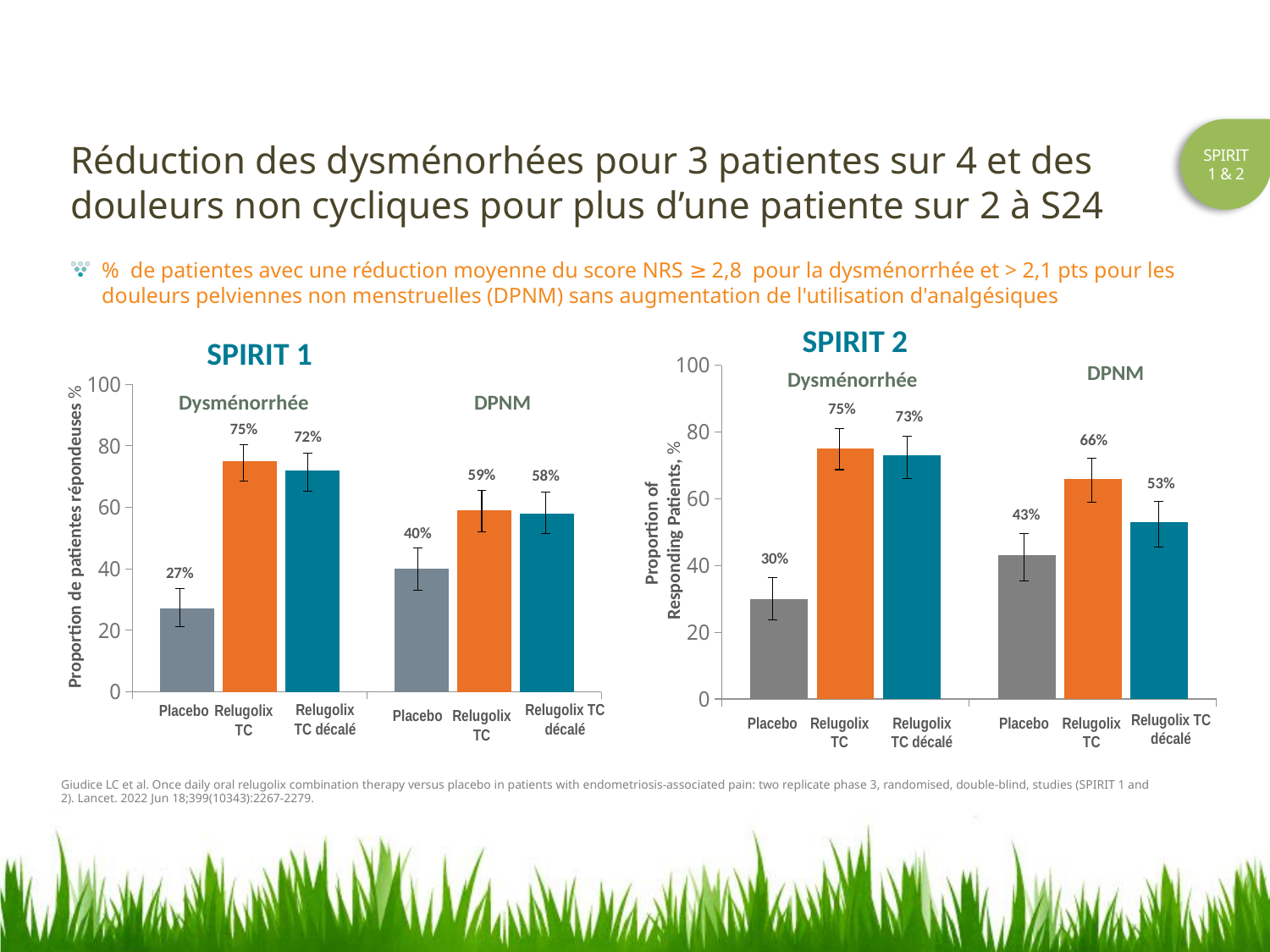
In the SPIRIT 1 chart, what is the value for Relugolix TC in the DPNM group? 59% In the SPIRIT 1 chart, is the value for Placebo in the DPNM group greater or less than 60? less What kind of chart is the SPIRIT 1 chart? Bar chart How many bars are plotted in the SPIRIT 2 chart? 6 In the SPIRIT 1 chart, what is the difference between Relugolix TC and Placebo in the Dysménorrhée group? 48% In the SPIRIT 2 chart, what is the difference between Relugolix TC and Placebo in the DPNM group? 23% In the SPIRIT 2 chart, what is the value for Relugolix TC décalé in the DPNM group? 53% In the SPIRIT 1 chart, what is the value for Placebo in the Dysménorrhée group? 27% In the SPIRIT 2 chart, which bar has the lowest value? Placebo (Dysménorrhée) In the SPIRIT 2 chart, which is larger: Relugolix TC in the DPNM group or Relugolix TC décalé in the DPNM group? Relugolix TC In the SPIRIT 1 chart, which bar has the highest value? Relugolix TC (Dysménorrhée) In the SPIRIT 2 chart, what is the value for Placebo in the Dysménorrhée group? 30%